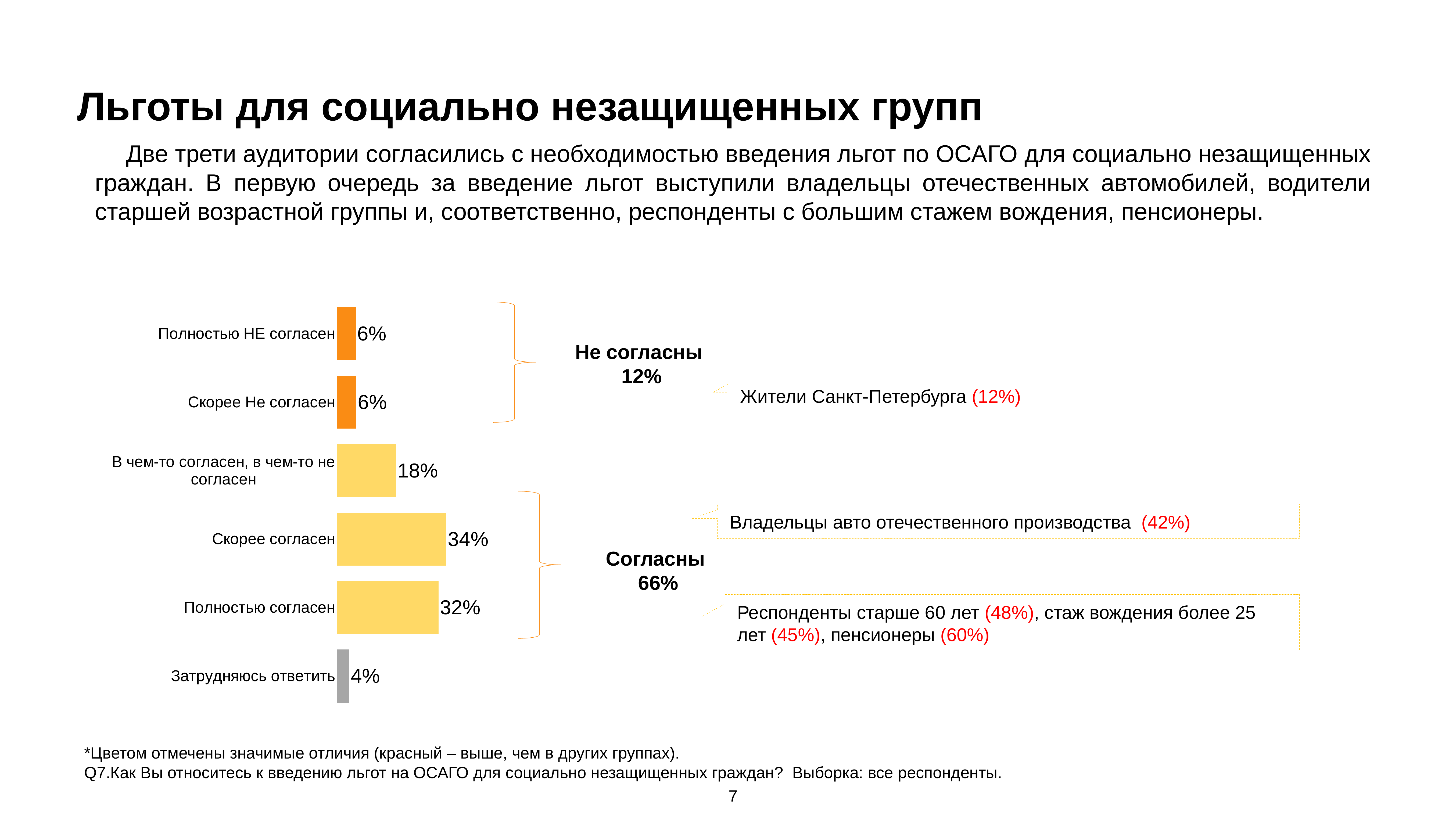
What combined share is labelled "Согласны" next to the chart? 66% What is the value for "Скорее согласен"? 34% What is the value for "Полностью согласен"? 32% How many categories are shown in the chart? 6 Which category has the highest value? Скорее согласен Which is larger: "В чем-то согласен, в чем-то не согласен" or "Скорее Не согласен"? В чем-то согласен, в чем-то не согласен What is the value for "Полностью НЕ согласен"? 6% Which category has the lowest value? Затрудняюсь ответить What kind of chart is shown on the slide? Bar chart What is the value for "Затрудняюсь ответить"? 4% What is the difference between "Скорее согласен" and "Полностью согласен"? 2% What is the value for "В чем-то согласен, в чем-то не согласен"? 18%